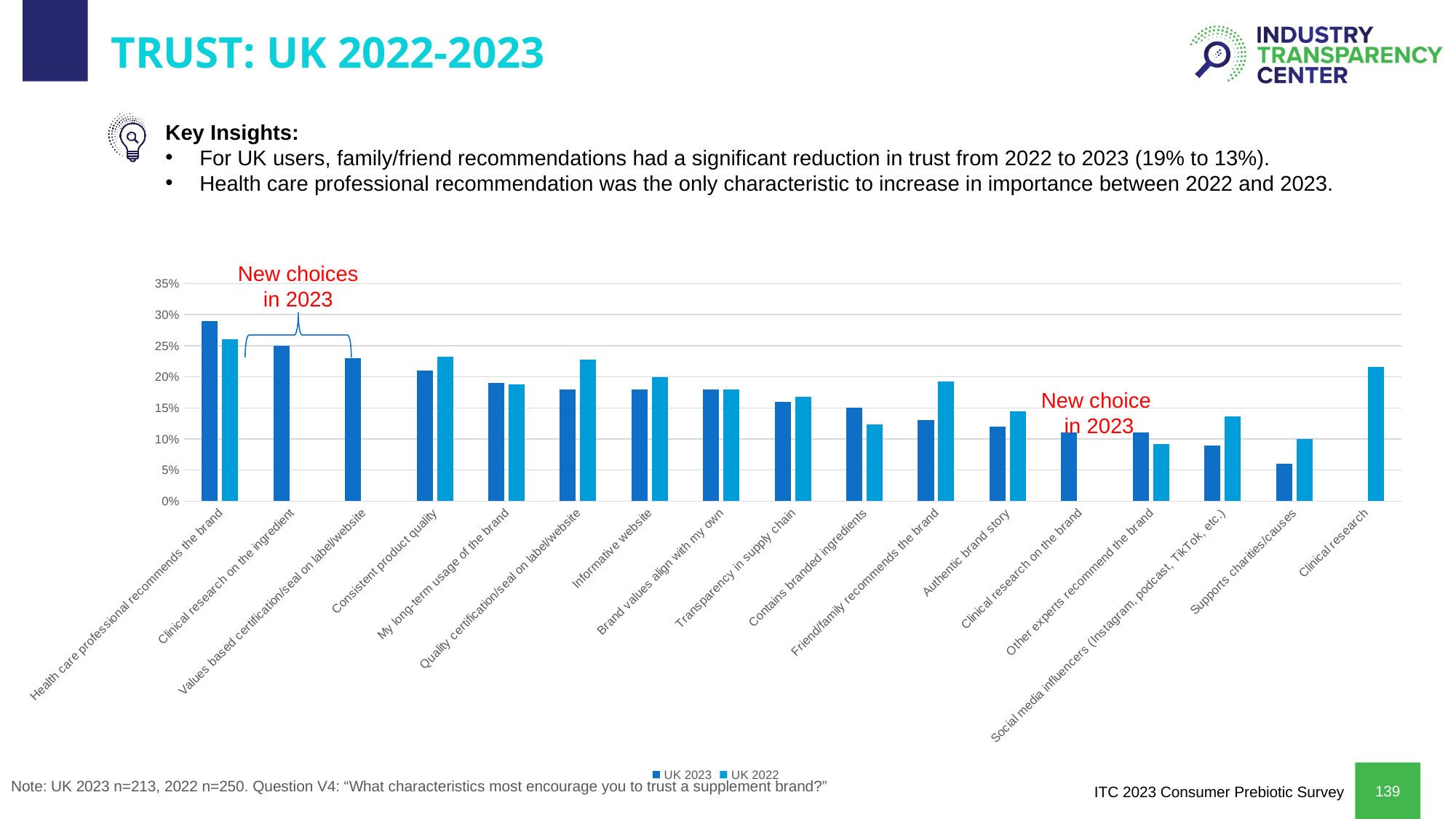
Which category has the highest UK 2023 value? Health care professional recommends the brand What is the UK 2022 value for 'Informative website'? 20% Do the UK 2023 values generally rise or fall moving from left to right along the x axis? Fall Which category has the highest UK 2022 value? Health care professional recommends the brand How many series does the chart legend list? 2 Is the UK 2023 value for 'Social media influencers (Instagram, podcast, TikTok, etc.)' greater or less than 10%? less Is the UK 2023 value for 'Health care professional recommends the brand' greater or less than 25%? greater How many categories are shown along the x axis of the chart? 17 Which category has the lowest UK 2023 value? Supports charities/causes What is the UK 2023 value for 'Clinical research on the ingredient'? 25% What kind of chart is shown on the slide? Bar chart For 'Friend/family recommends the brand', which is larger: the UK 2022 value or the UK 2023 value? UK 2022